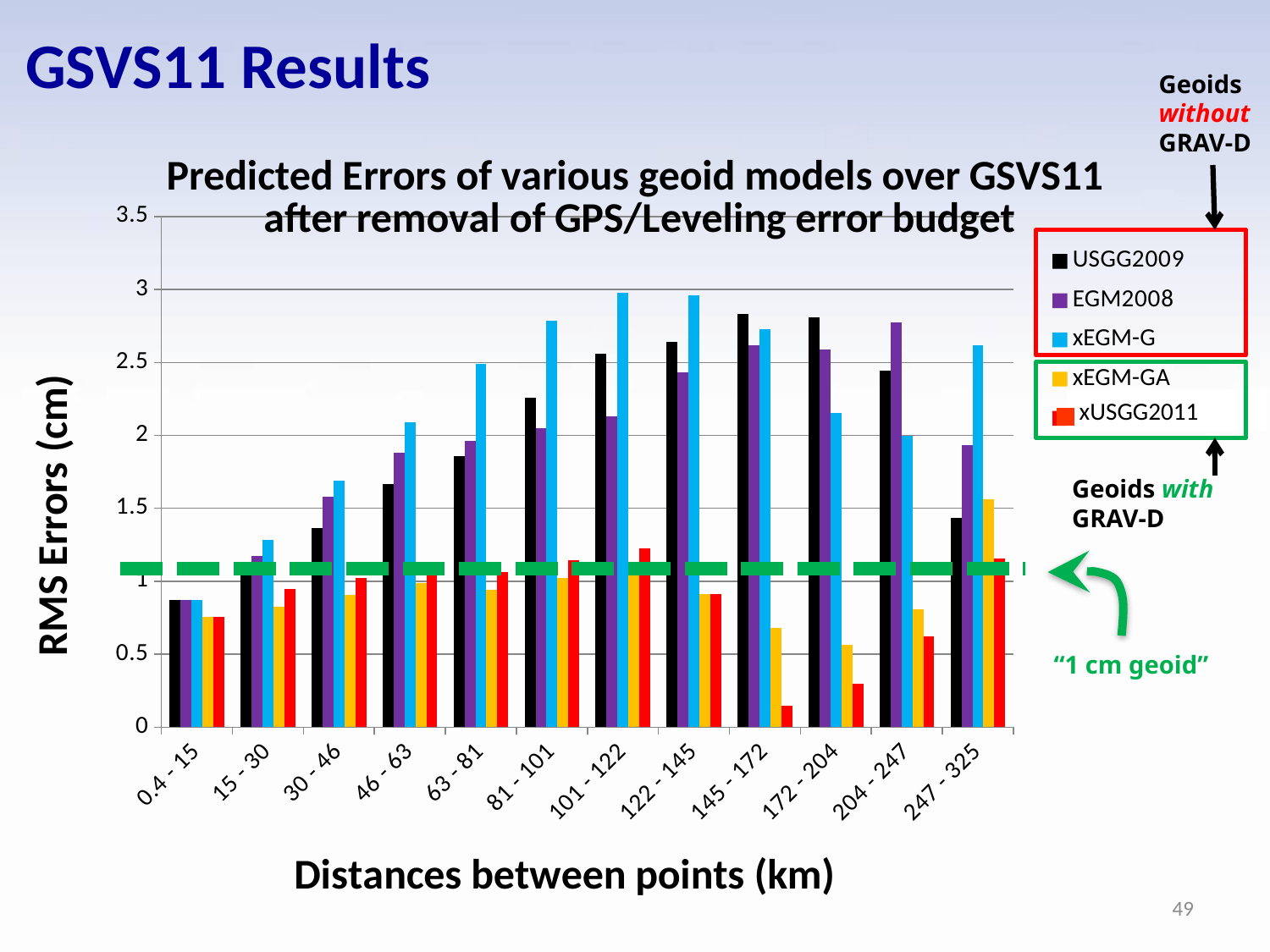
Is the value for xEGM-GA in the 247 - 325 km category greater or less than 1? greater In the 81 - 101 km category, which is larger: USGG2009 or EGM2008? USGG2009 Which series has the highest value in the 46 - 63 km category? xEGM-G What kind of chart is shown on the slide? bar chart How many series does the legend list? 5 In the 204 - 247 km category, which is larger: USGG2009 or EGM2008? EGM2008 Is the value for xUSGG2011 in the 145 - 172 km category greater or less than 0.5? less How many distance categories are shown along the x axis? 12 Which series has the lowest value in the 172 - 204 km category? xUSGG2011 What is the title of the y axis? RMS Errors (cm) Do the xEGM-G values rise or fall from the 0.4 - 15 km category to the 101 - 122 km category? rise Is the value for xEGM-G in the 101 - 122 km category greater or less than 2.5? greater